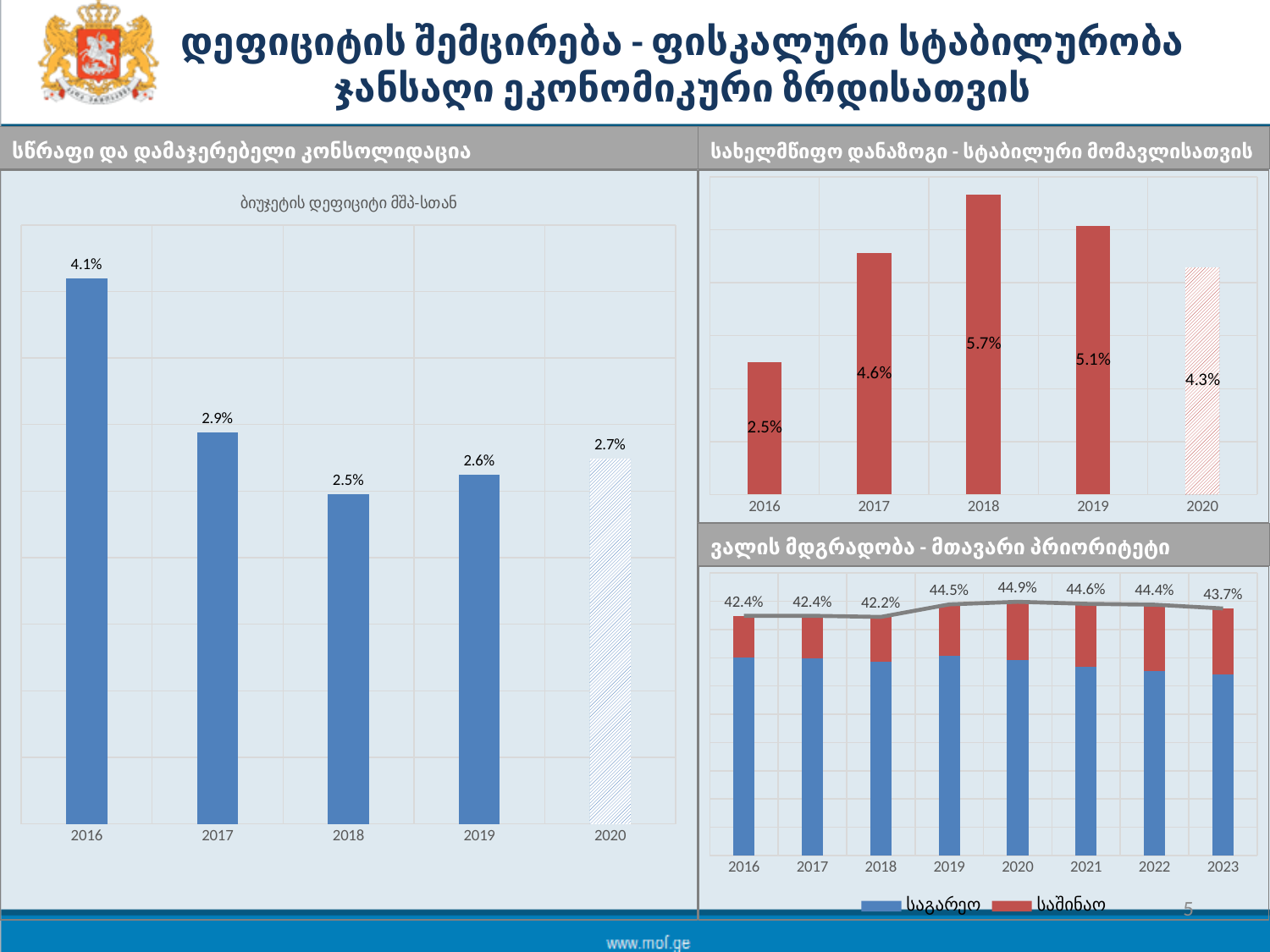
In the top-right chart, which year has the highest value? 2018 In the left chart (budget deficit to GDP), what kind of chart is it? bar chart In the top-right chart, what is the difference between the 2017 and 2016 values? 2.1% In the top-right chart, which year has the lowest value? 2016 In the left chart (budget deficit to GDP), what is the difference between the 2016 and 2020 values? 1.4% In the left chart (budget deficit to GDP), what is the value for 2016? 4.1% In the bottom-right stacked chart, what is the total value for 2020? 44.9% In the left chart (budget deficit to GDP), which year has the lowest value? 2018 In the left chart (budget deficit to GDP), how many years are shown on the x axis? 5 In the bottom-right stacked chart, how many series does the legend list? 2 In the top-right chart, what is the value for 2018? 5.7% In the bottom-right stacked chart, how many years are shown on the x axis? 8